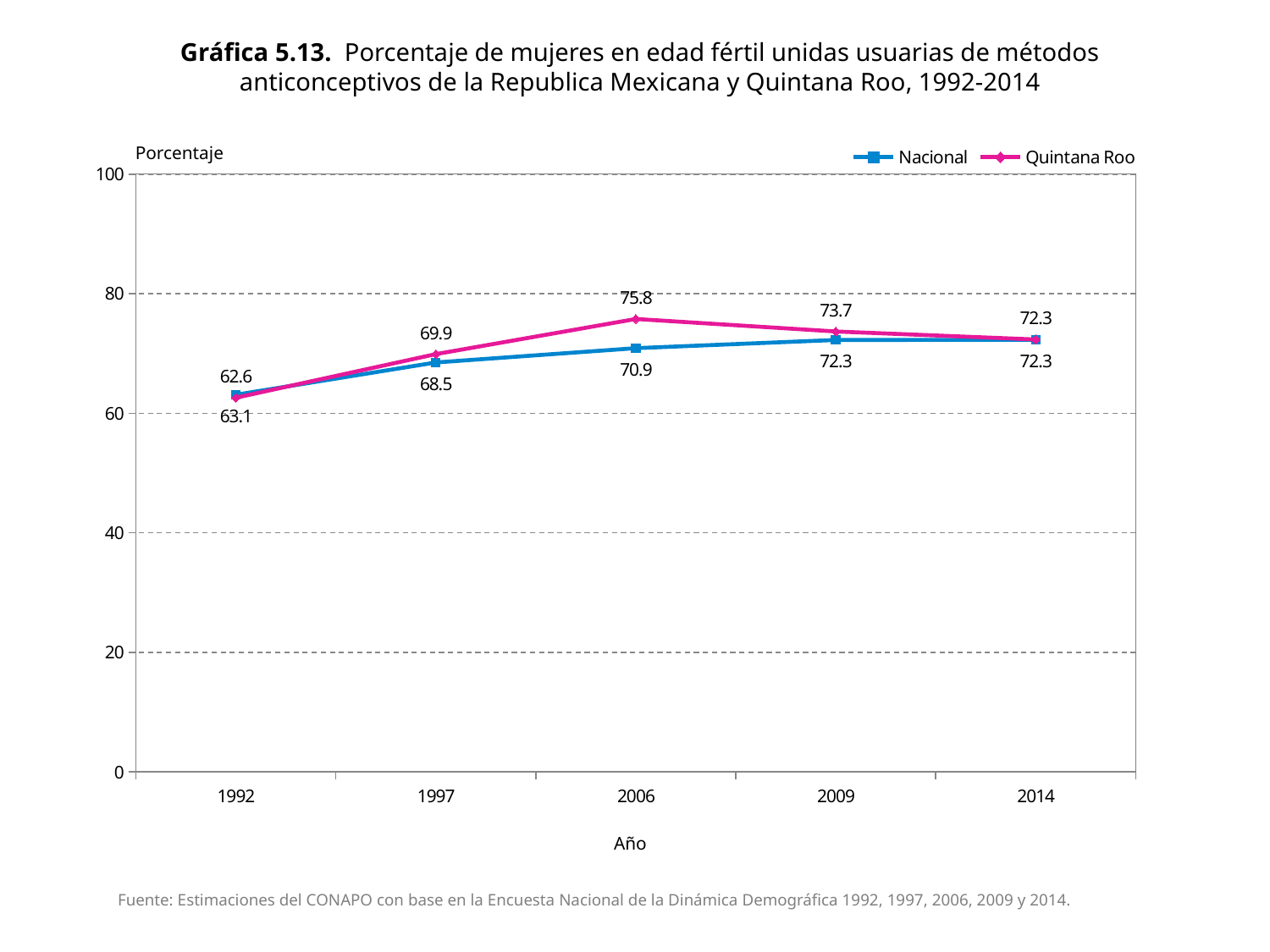
What is the value for Nacional in 1997? 68.5 What is the value for Quintana Roo in 2006? 75.8 In which year is the Nacional series at its lowest value? 1992 Is the value for Nacional in 2009 greater or less than 60? greater What is the value for Nacional in 2014? 72.3 What kind of chart is shown on the slide? line chart How many years are plotted along the x axis? 5 How many series does the legend list? 2 What is the difference between the Quintana Roo and Nacional values in 2006? 4.9 In 1997, which series has the larger value, Nacional or Quintana Roo? Quintana Roo In which year does the Quintana Roo series reach its highest value? 2006 Does the Nacional series rise or fall from 1992 to 2014? rise